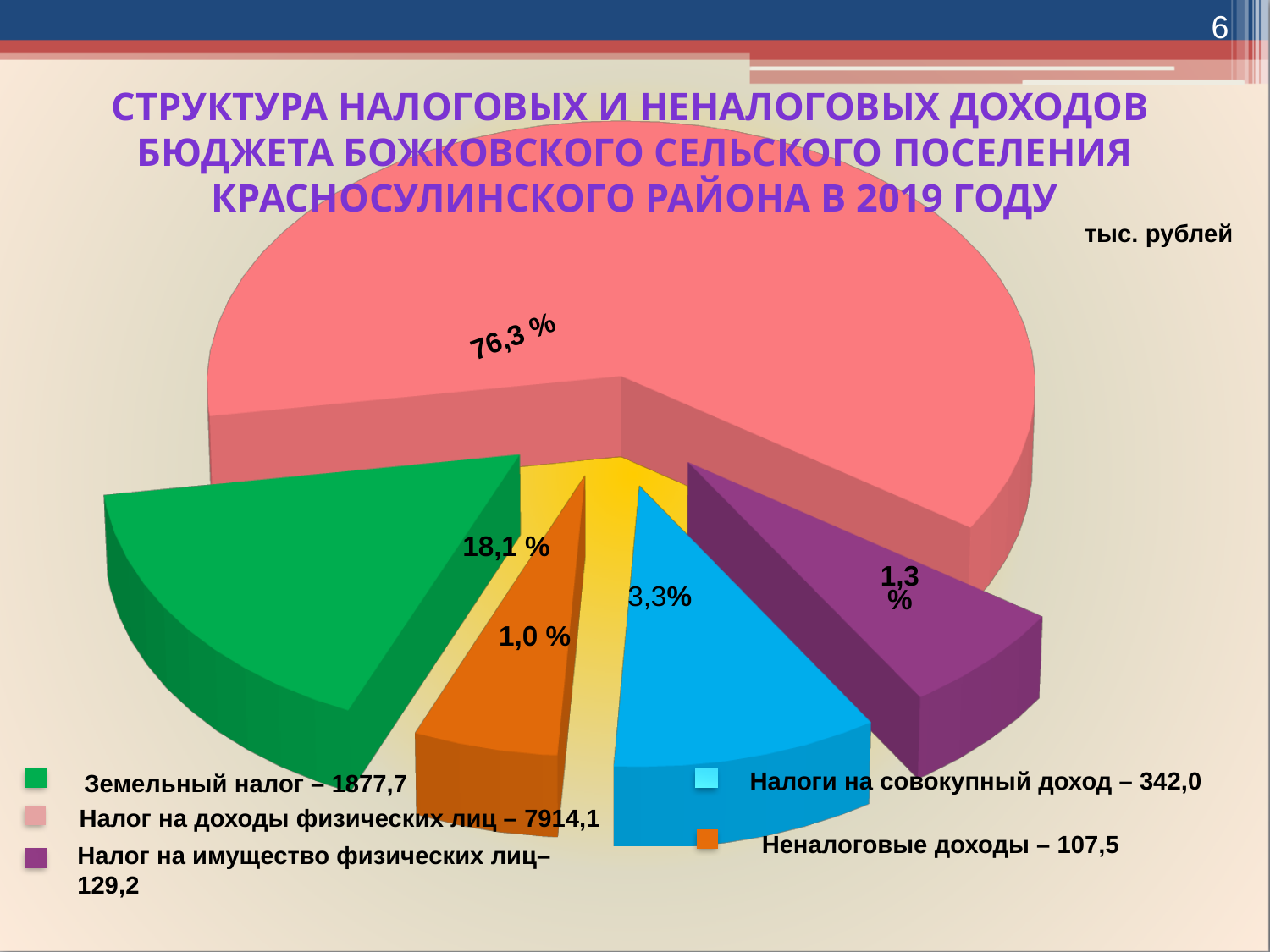
What is the value for Налог на доходы физических лиц shown in the legend? 7914,1 Which category has the smallest value in the legend? Неналоговые доходы In what units are the values on the chart given, according to the note on the slide? тыс. рублей What share of the pie does the largest slice (Налог на доходы физических лиц) represent? 76,3 % What is the value for Неналоговые доходы shown in the legend? 107,5 What is the value for Налоги на совокупный доход shown in the legend? 342,0 What is the difference between the values for Налоги на совокупный доход and Налог на имущество физических лиц? 212,8 What share of the pie does the green slice (Земельный налог) represent? 18,1 % What kind of chart is shown on the slide? pie chart How many slices does the pie chart have? 5 Which category has the largest slice of the pie? Налог на доходы физических лиц What is the value for Земельный налог shown in the legend? 1877,7